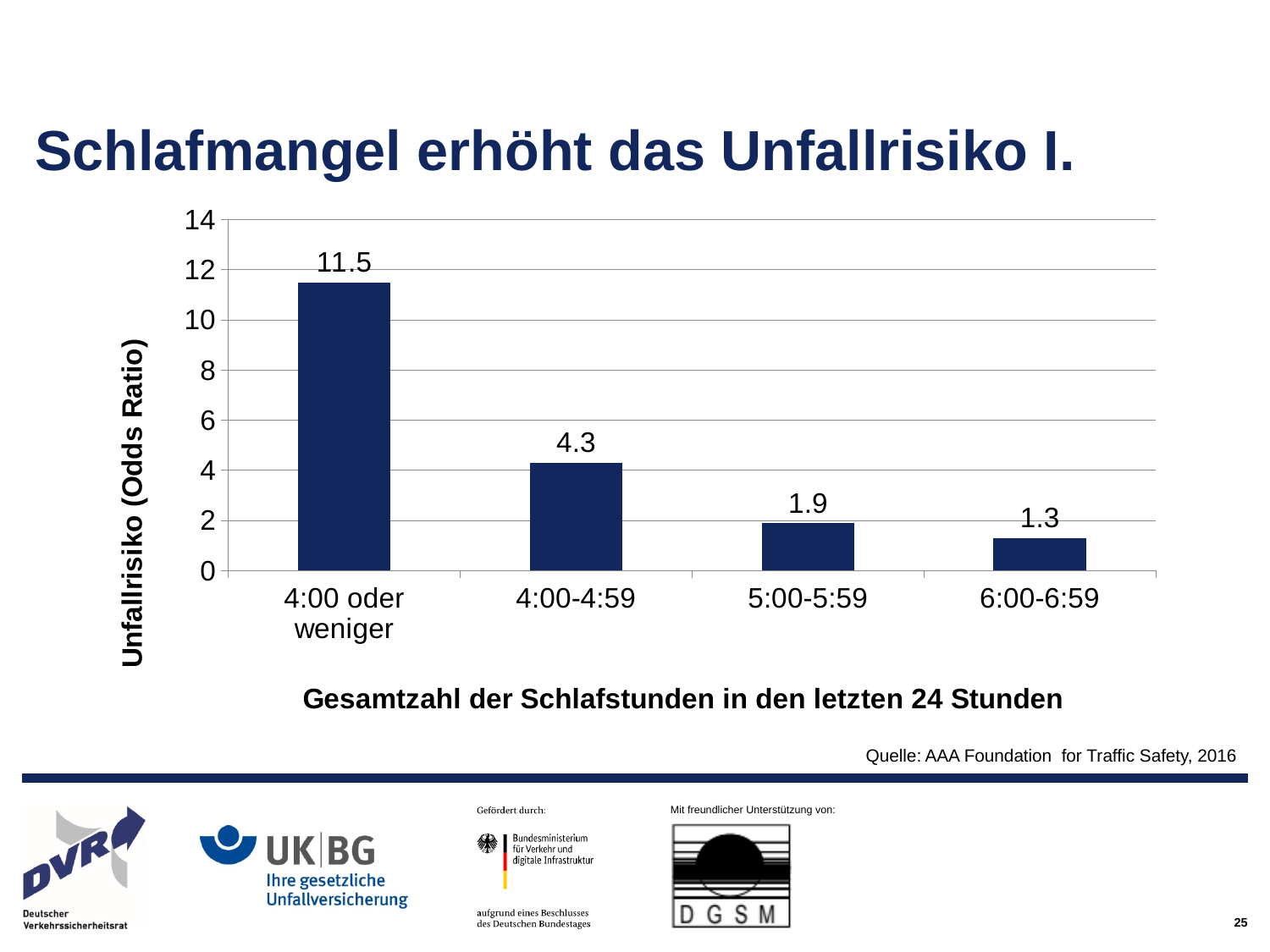
How many sleep-hours categories are shown on the x axis? 4 What is the Unfallrisiko (Odds Ratio) for the category "5:00-5:59"? 1.9 Which has a larger Odds Ratio: "5:00-5:59" or "6:00-6:59"? 5:00-5:59 What is the Unfallrisiko (Odds Ratio) for the category "4:00 oder weniger"? 11.5 Is the Odds Ratio for "4:00-4:59" greater or less than 6? less Which sleep-hours category has the highest Unfallrisiko (Odds Ratio)? 4:00 oder weniger Do the Odds Ratio values rise or fall as the number of sleep hours increases along the x axis? Fall Which sleep-hours category has the lowest Unfallrisiko (Odds Ratio)? 6:00-6:59 What kind of chart is shown on the slide? Bar chart What is the Unfallrisiko (Odds Ratio) for the category "4:00-4:59"? 4.3 What is the Unfallrisiko (Odds Ratio) for the category "6:00-6:59"? 1.3 What is the difference between the Odds Ratio for "4:00 oder weniger" and for "4:00-4:59"? 7.2